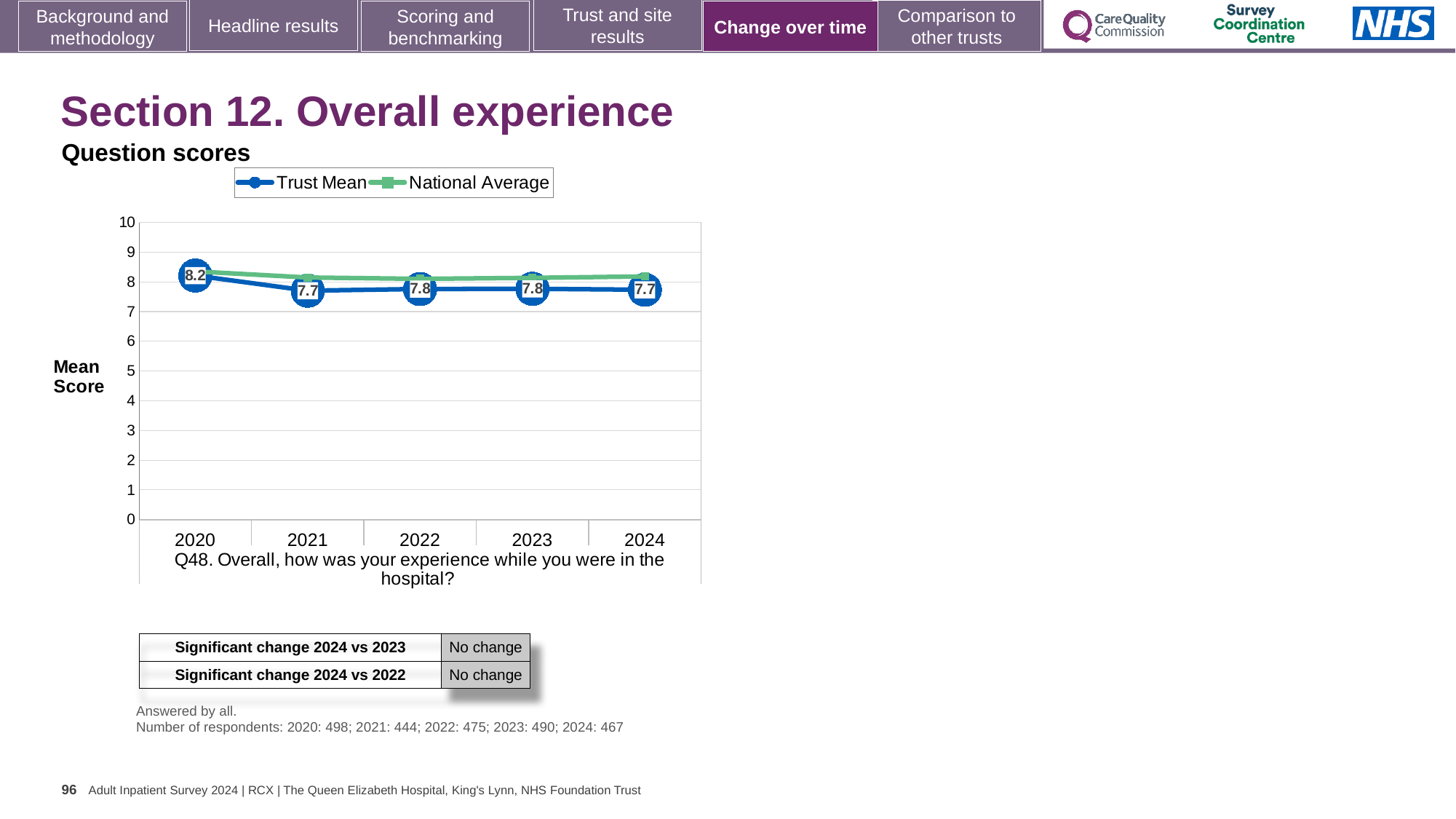
Which series is shown in green in the legend? National Average What kind of chart is shown on the slide? Line chart In which year is the Trust Mean score highest? 2020 What is the difference between the Trust Mean score in 2020 and in 2021? 0.5 Is the Trust Mean score for 2020 larger than the Trust Mean score for 2024? Yes How many years are shown on the x axis? 5 Does the Trust Mean score rise or fall from 2020 to 2021? Fall Is the National Average value for 2024 greater or less than 7? greater How many series does the legend list? 2 What is the Trust Mean score for 2024? 7.7 What is the Trust Mean score for 2022? 7.8 What is the Trust Mean score for 2020? 8.2